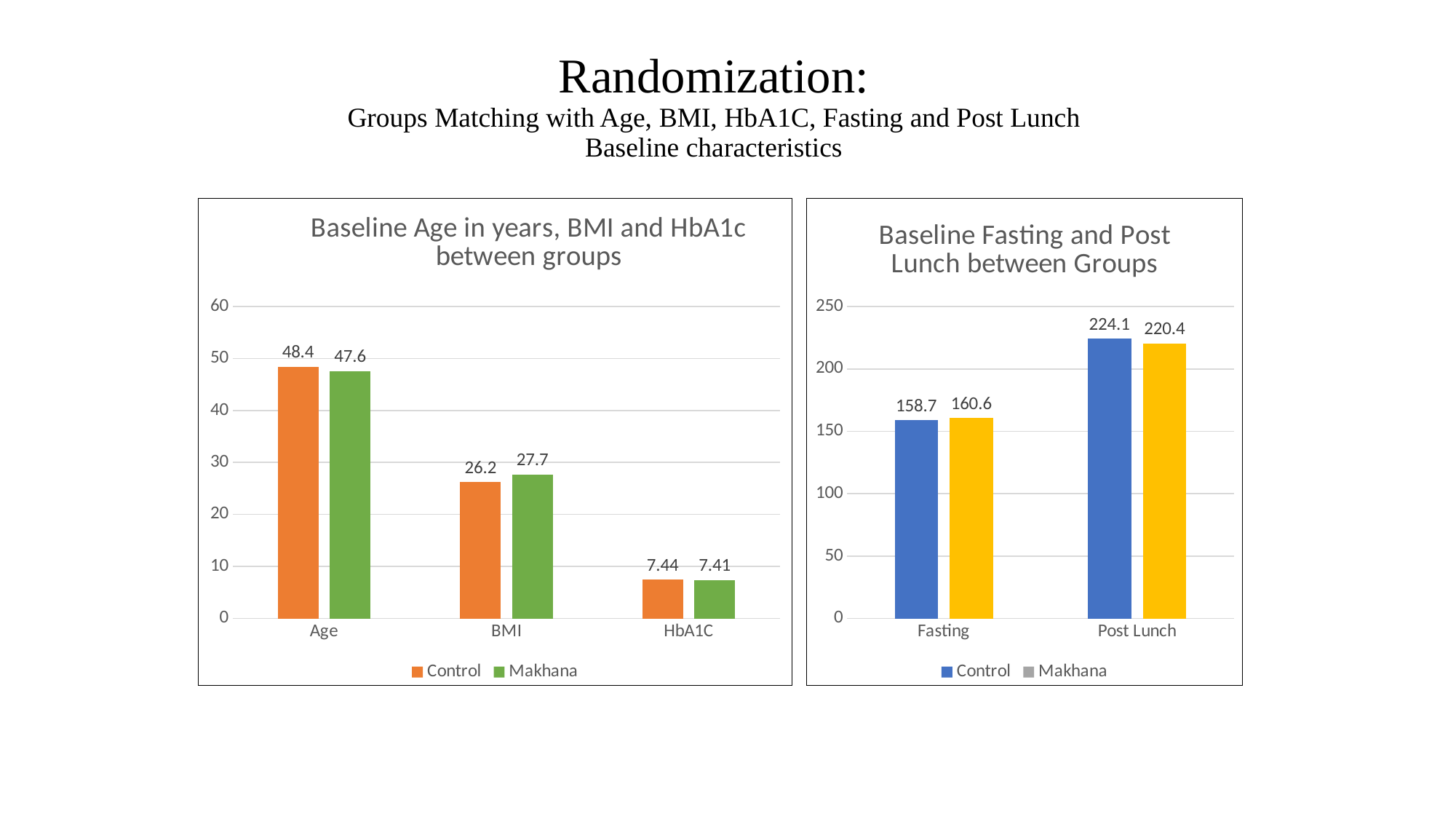
In the right chart (Baseline Fasting and Post Lunch between Groups), what is the Makhana value for Fasting? 160.6 In the left chart (Baseline Age in years, BMI and HbA1c between groups), what is the Control value for Age? 48.4 In the left chart (Baseline Age in years, BMI and HbA1c between groups), how many categories are shown on the x axis? 3 What kind of chart is the right chart (Baseline Fasting and Post Lunch between Groups)? Bar chart In the right chart (Baseline Fasting and Post Lunch between Groups), how many series does the legend list? 2 In the right chart (Baseline Fasting and Post Lunch between Groups), what is the difference between the Control and Makhana values for Post Lunch? 3.7 In the right chart (Baseline Fasting and Post Lunch between Groups), is the Control value for Fasting greater or less than 150? greater In the right chart (Baseline Fasting and Post Lunch between Groups), what is the Control value for Post Lunch? 224.1 In the left chart (Baseline Age in years, BMI and HbA1c between groups), what is the Control value for HbA1C? 7.44 In the left chart (Baseline Age in years, BMI and HbA1c between groups), what is the difference between the Makhana and Control values for BMI? 1.5 In the left chart (Baseline Age in years, BMI and HbA1c between groups), which category has the highest Control value? Age In the left chart (Baseline Age in years, BMI and HbA1c between groups), what is the Makhana value for BMI? 27.7